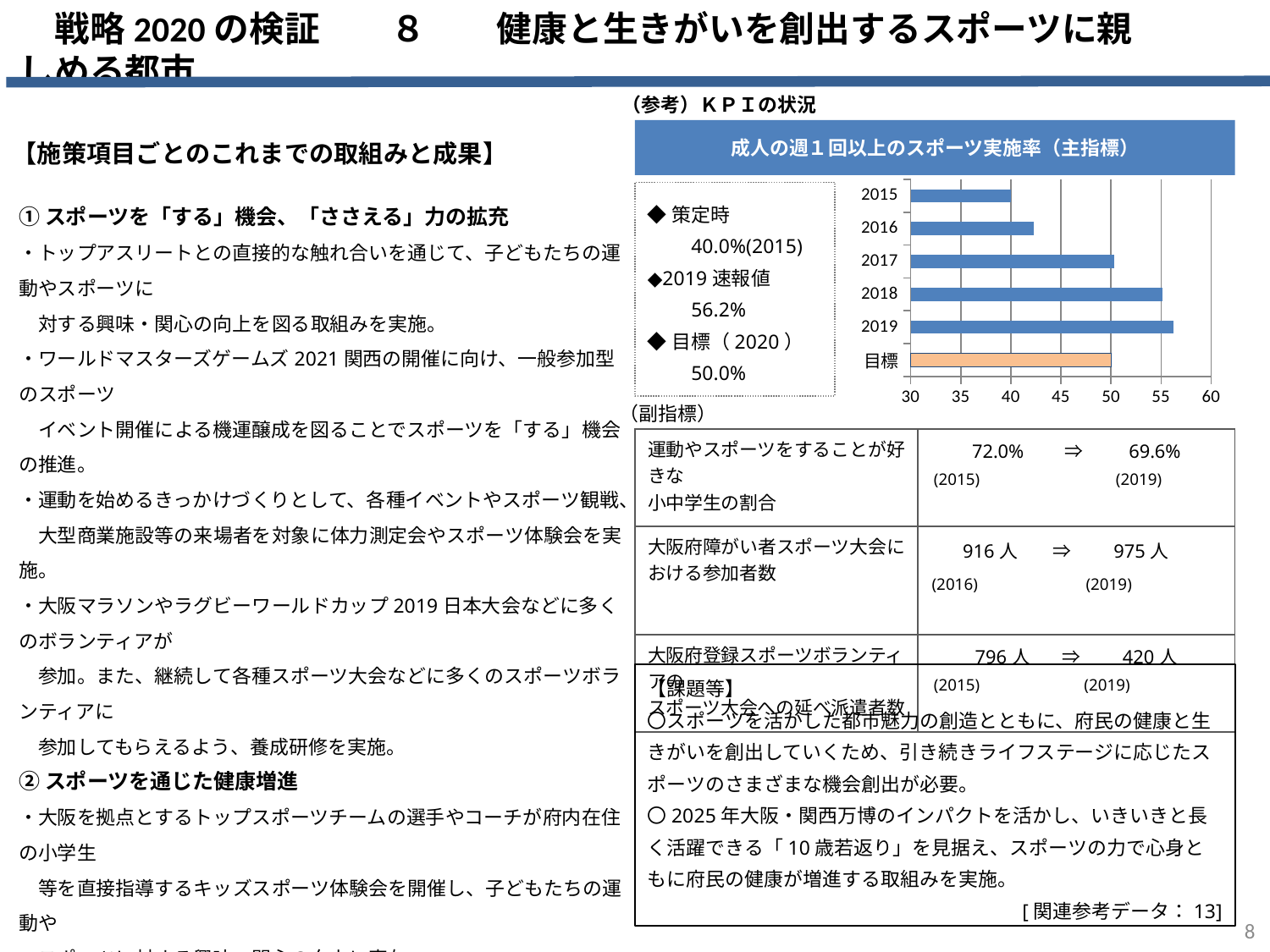
Do the values rise or fall from 2015 to 2019? rise Which year has the lowest value in the chart? 2015 What is the value for 2019 in the chart? 56.2% Which is larger, the value for 2018 or the value for 2016? 2018 What is the difference between the 2019 value and the 2015 value? 16.2 percentage points Is the value for 2018 greater or less than 50? greater What is the value for 2015 in the chart? 40.0% How many bars are plotted in the chart? 6 Is the value for 2016 greater or less than 45? less What is the value of the 目標 bar in the chart? 50.0% What type of chart is shown under the heading 成人の週１回以上のスポーツ実施率（主指標）? bar chart Which year has the highest value in the chart? 2019